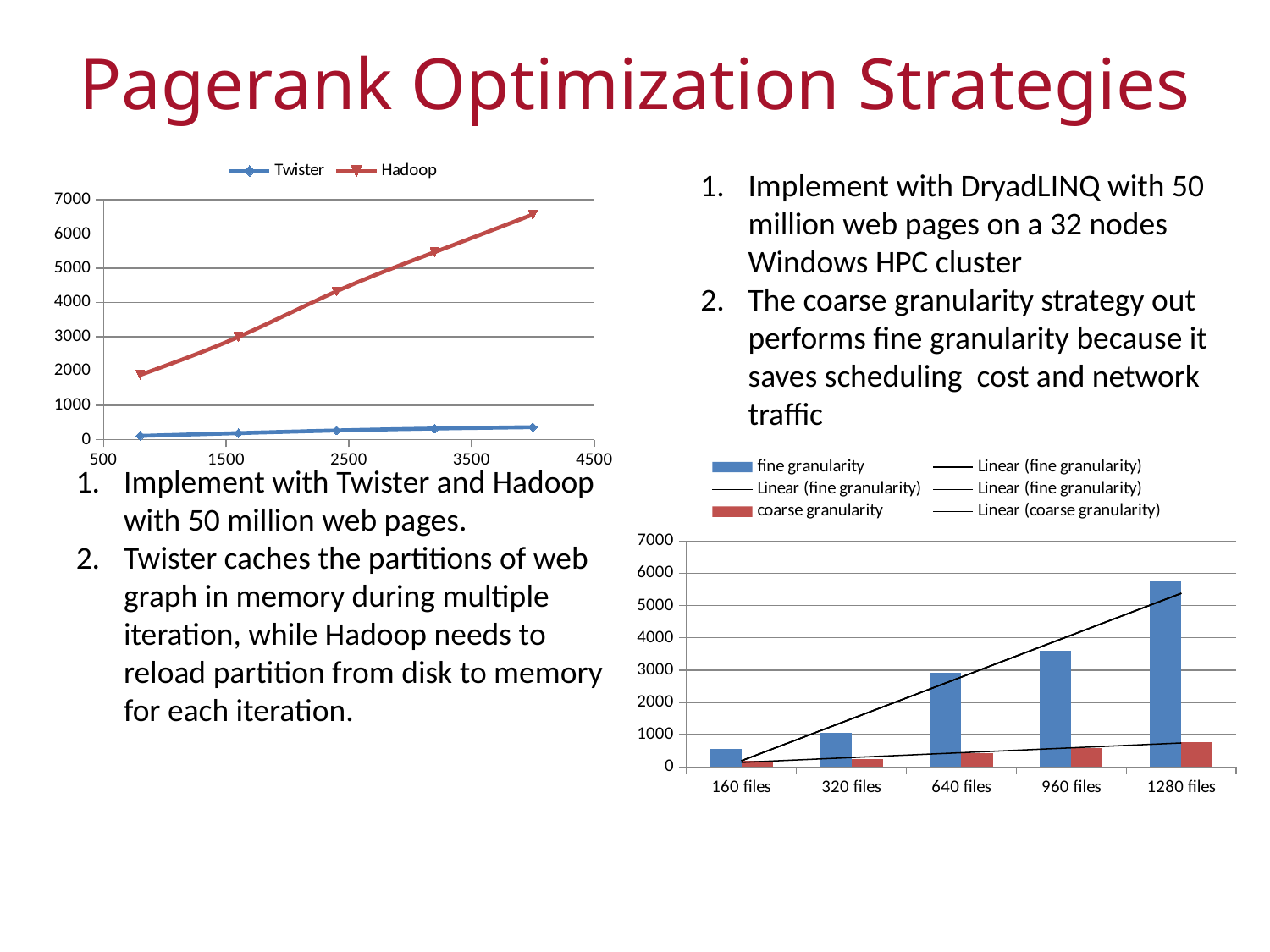
In the left chart (Twister vs Hadoop), is the Hadoop value at the rightmost data point greater or less than 6000? greater In the right chart (fine granularity vs coarse granularity), is the fine granularity value for 640 files greater or less than 2000? greater In the left chart (Twister vs Hadoop), do the Hadoop values rise or fall as the x-axis value increases? rise How many categories are shown on the x-axis of the right chart (fine granularity vs coarse granularity)? 5 What kind of chart is the chart on the right of the slide (fine granularity vs coarse granularity)? bar chart How many series does the legend of the left chart (Twister vs Hadoop) list? 2 In the right chart (fine granularity vs coarse granularity), which series has the larger value for 960 files? fine granularity What kind of chart is the chart on the left of the slide (Twister vs Hadoop)? line chart In the right chart (fine granularity vs coarse granularity), which category has the highest fine granularity bar? 1280 files In the left chart (Twister vs Hadoop), is the Twister value at the rightmost data point greater or less than 1000? less In the right chart (fine granularity vs coarse granularity), do the fine granularity bars rise or fall from 160 files to 1280 files? rise In the left chart (Twister vs Hadoop), which series has the higher value at the rightmost data point? Hadoop